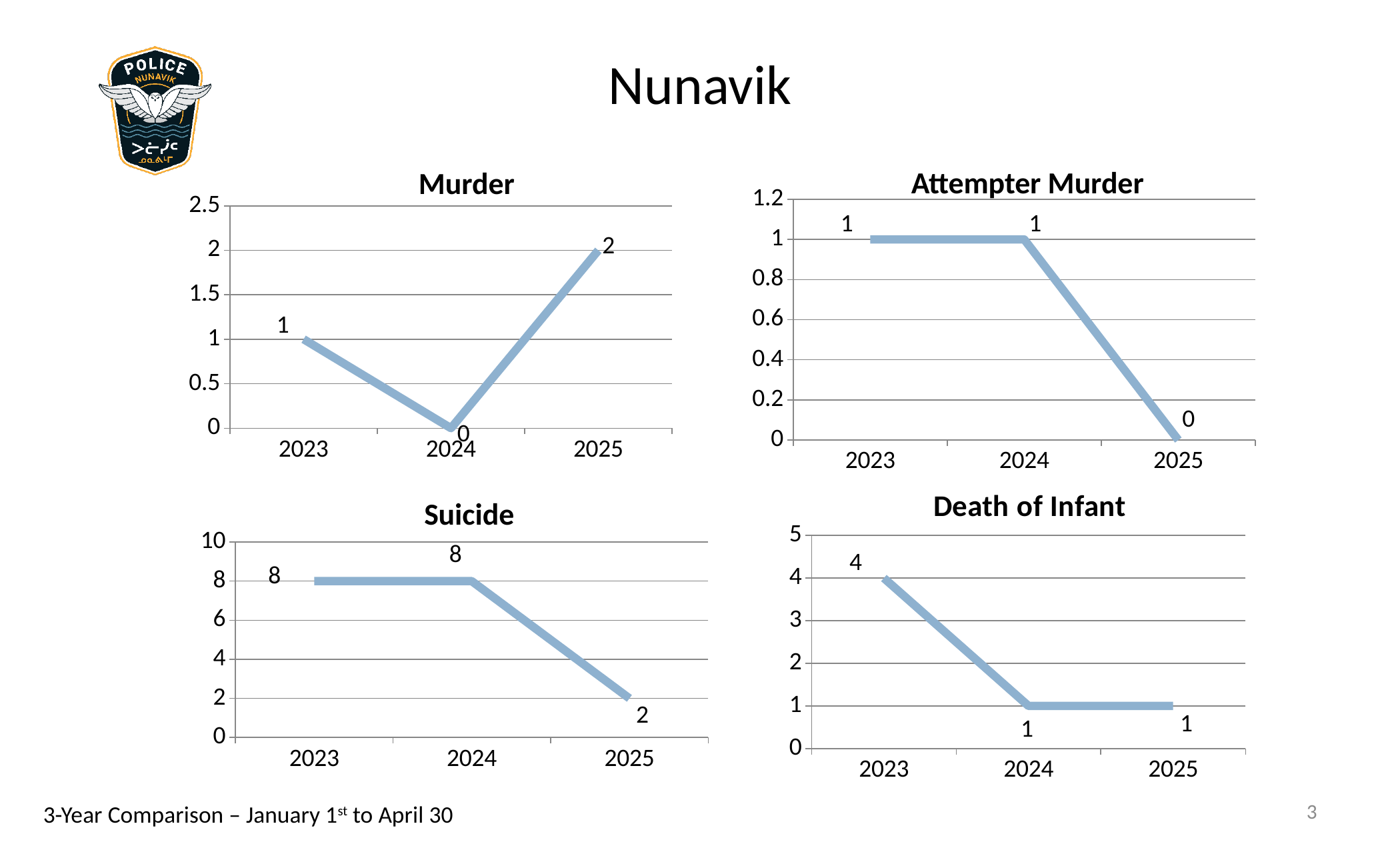
In the Attempter Murder chart, what is the value for 2024? 1 In the Attempter Murder chart, what is the difference between the 2023 value and the 2025 value? 1 In the Murder chart, which year has the lowest value? 2024 In the Death of Infant chart, which is larger, the value for 2023 or the value for 2025? 2023 What kind of chart is the Suicide chart? Line chart In the Death of Infant chart, do the values rise or fall from 2023 to 2024? Fall In the Murder chart, what is the value for 2025? 2 In the Suicide chart, what is the difference between the 2024 value and the 2025 value? 6 In the Death of Infant chart, how many years are plotted? 3 In the Suicide chart, is the value for 2023 greater or less than 6? greater In the Death of Infant chart, which year has the highest value? 2023 In the Suicide chart, what is the value for 2025? 2